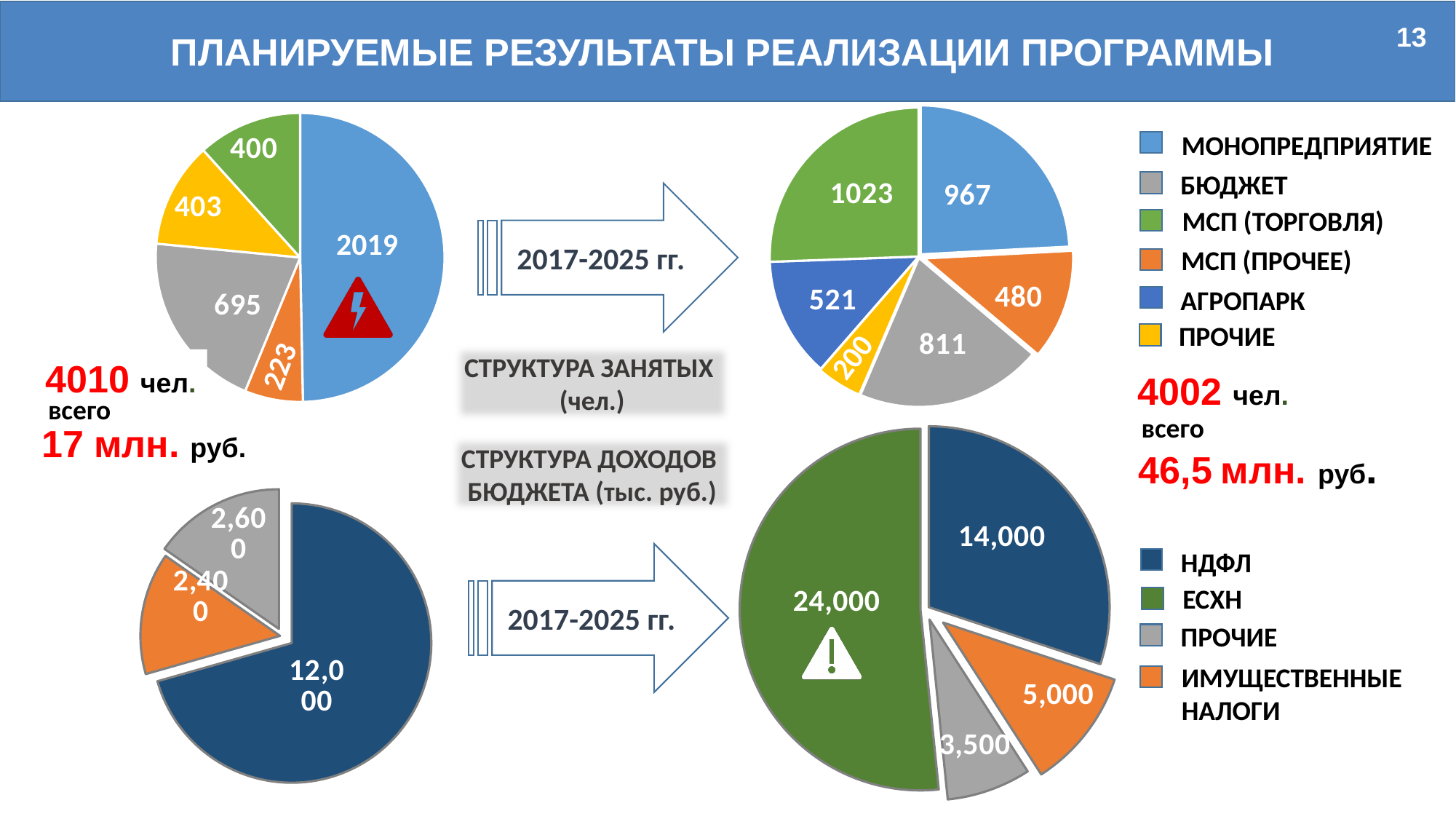
In the bottom-right pie chart (budget revenue structure, 2025), what is the value for ЕСХН? 24,000 In the top-right pie chart (employment structure, 2025), which is larger: БЮДЖЕТ or МСП (ПРОЧЕЕ)? БЮДЖЕТ In the bottom-left pie chart (budget revenue structure, 2017), what is the difference between НДФЛ and ПРОЧИЕ? 9,400 How many entries does the legend for the budget revenue pie charts (bottom) list? 4 What type of charts are shown on the slide? Pie charts How many slices does the top-right pie chart (employment structure, 2025) have? 6 In the top-right pie chart (employment structure, 2025), what is the value for АГРОПАРК? 521 In the top-right pie chart (employment structure, 2025), which category has the largest value? МСП (ТОРГОВЛЯ) In the top-left pie chart (employment structure, 2017), what is the value for МОНОПРЕДПРИЯТИЕ? 2019 In the top-left pie chart (employment structure, 2017), what is the difference between БЮДЖЕТ and МСП (ПРОЧЕЕ)? 472 In the bottom-right pie chart (budget revenue structure, 2025), which category has the smallest value? ПРОЧИЕ In the top-right pie chart (employment structure, 2025), which category has the smallest value? ПРОЧИЕ